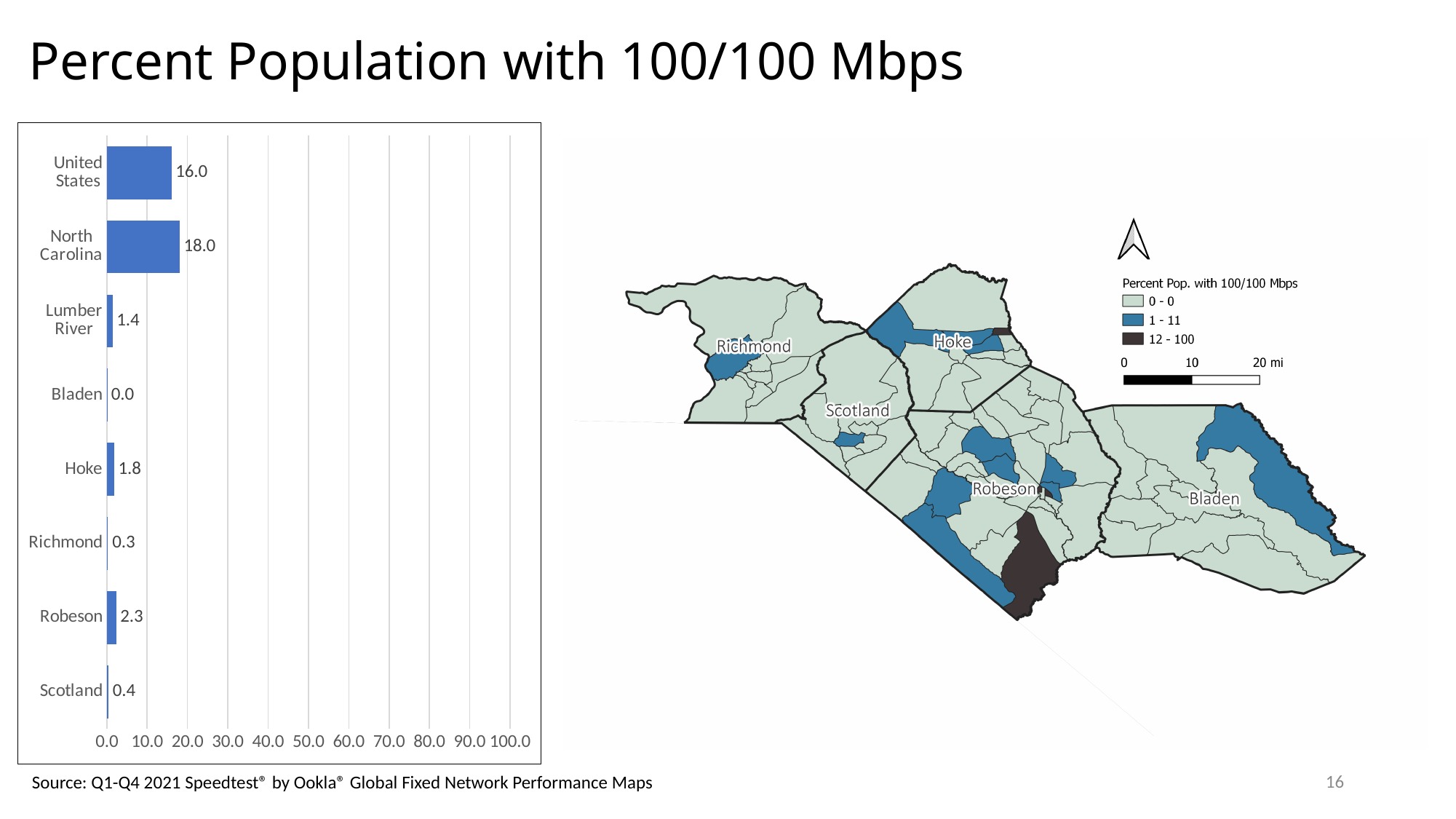
What is the value for Lumber River in the bar chart? 1.4 What is the value for the United States in the bar chart? 16.0 How many categories are shown in the bar chart? 8 In the bar chart, which is larger, the value for Hoke or the value for Richmond? Hoke What kind of chart is shown on the left of the slide? Bar chart What is the value for Robeson in the bar chart? 2.3 Which category has the highest value in the bar chart? North Carolina What is the maximum value shown on the x axis of the bar chart? 100.0 Is the value for North Carolina in the bar chart greater or less than 10.0? greater What is the value for North Carolina in the bar chart? 18.0 Which category has the lowest value in the bar chart? Bladen What is the difference between the North Carolina and United States values in the bar chart? 2.0